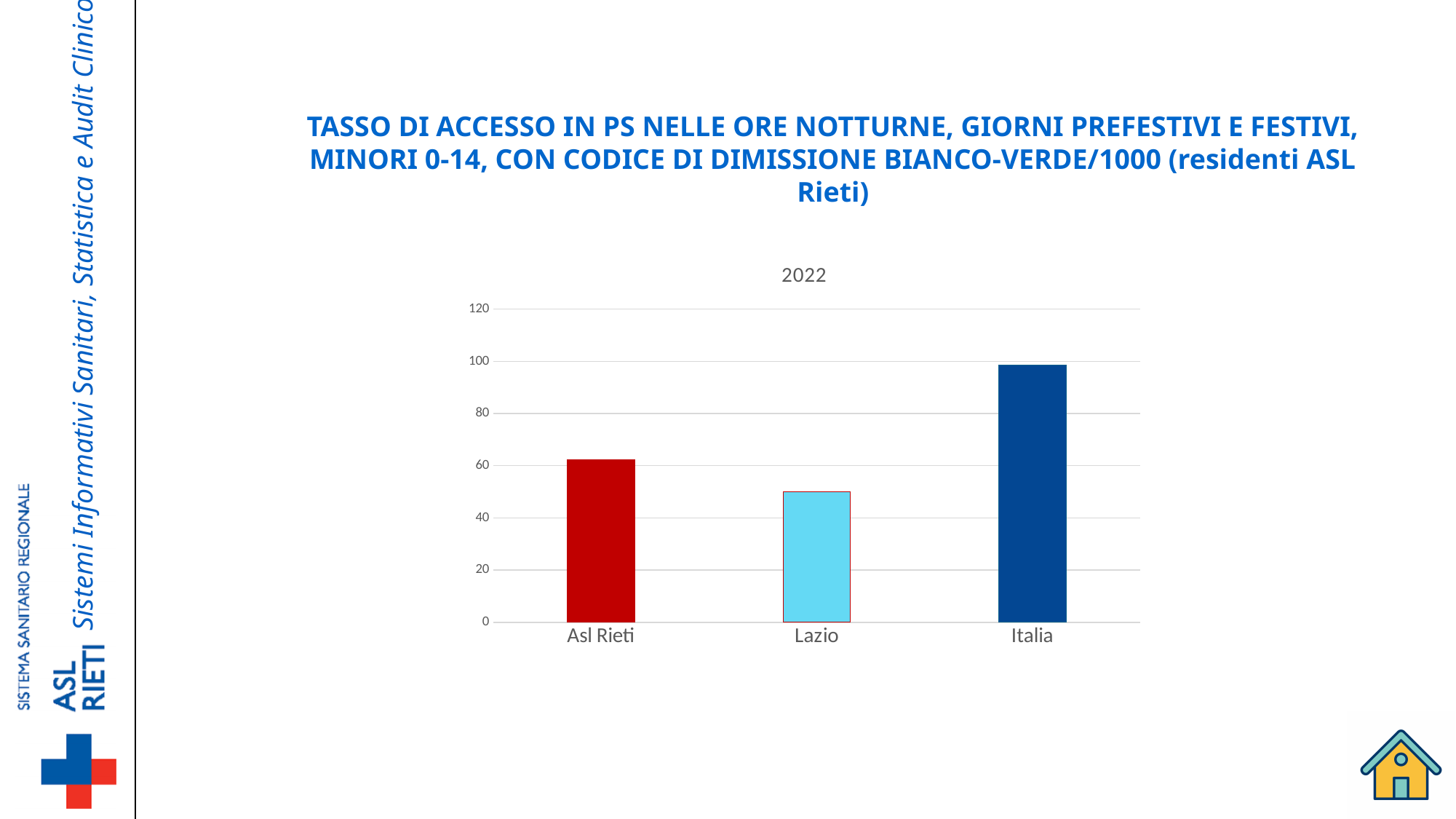
Is the value for Asl Rieti greater or less than 40? greater Is the value for Lazio greater or less than 60? less Which category has the lowest value in the chart? Lazio Which has the larger value, Italia or Asl Rieti? Italia What colour is the bar for Asl Rieti? red Is the value for Italia greater or less than 80? greater What kind of chart is shown on the slide? bar chart How many categories are plotted in the chart? 3 Which category has the highest value in the chart? Italia Which has the larger value, Asl Rieti or Lazio? Asl Rieti What year is shown as the chart's title above the plot area? 2022